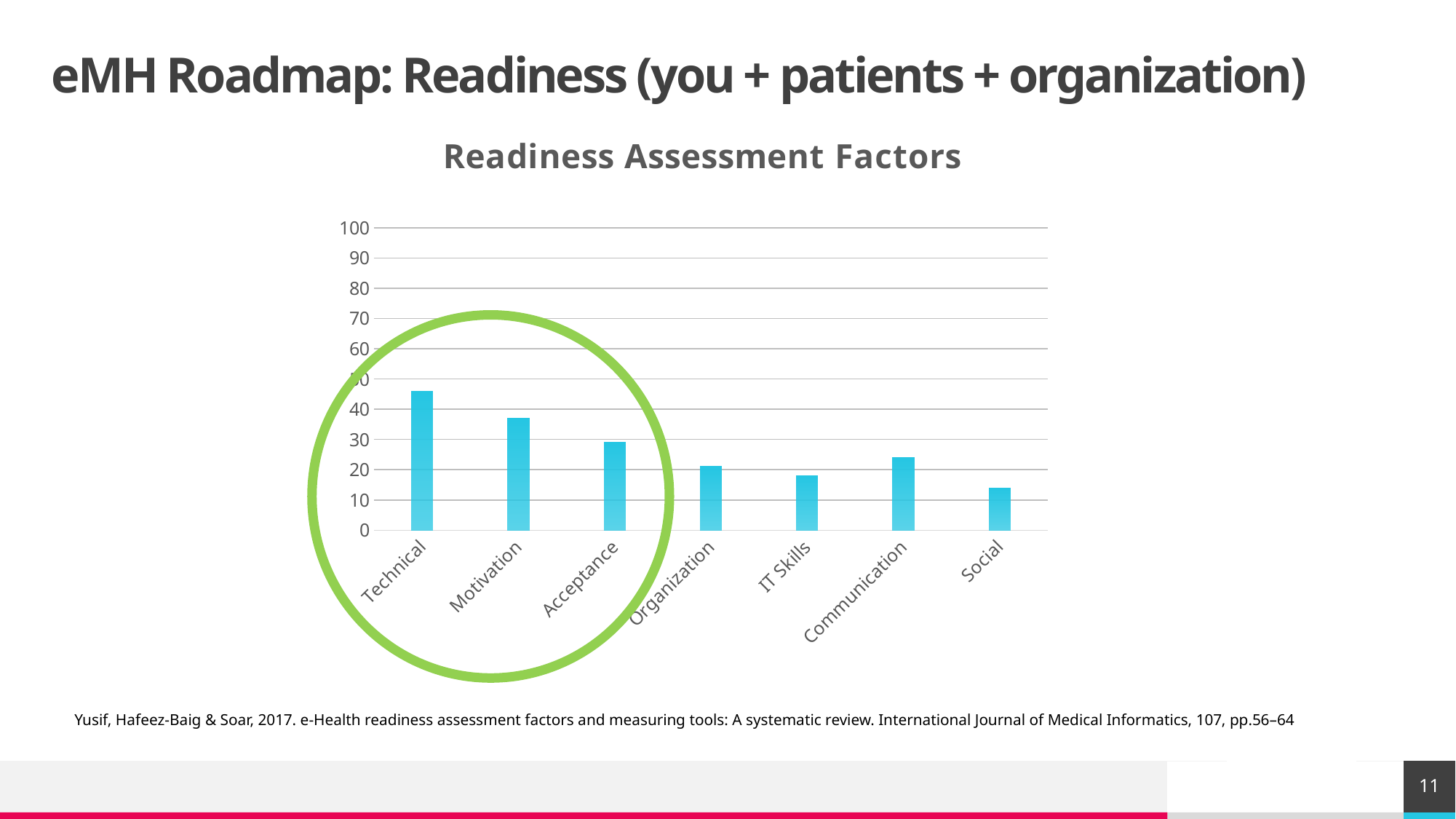
Which categories are enclosed by the green circle on the chart? Technical, Motivation, Acceptance What type of chart is shown on the slide? Bar chart Which category has the lowest value? Social How many categories are plotted on the x axis? 7 Which is larger, the value for Motivation or the value for Acceptance? Motivation What is the title of the chart? Readiness Assessment Factors Is the value for Motivation greater or less than 40? less Is the value for Communication greater or less than 20? greater Do the values rise or fall across the first three categories, from Technical to Acceptance? fall Is the value for Social greater or less than 20? less Which category has the highest value? Technical